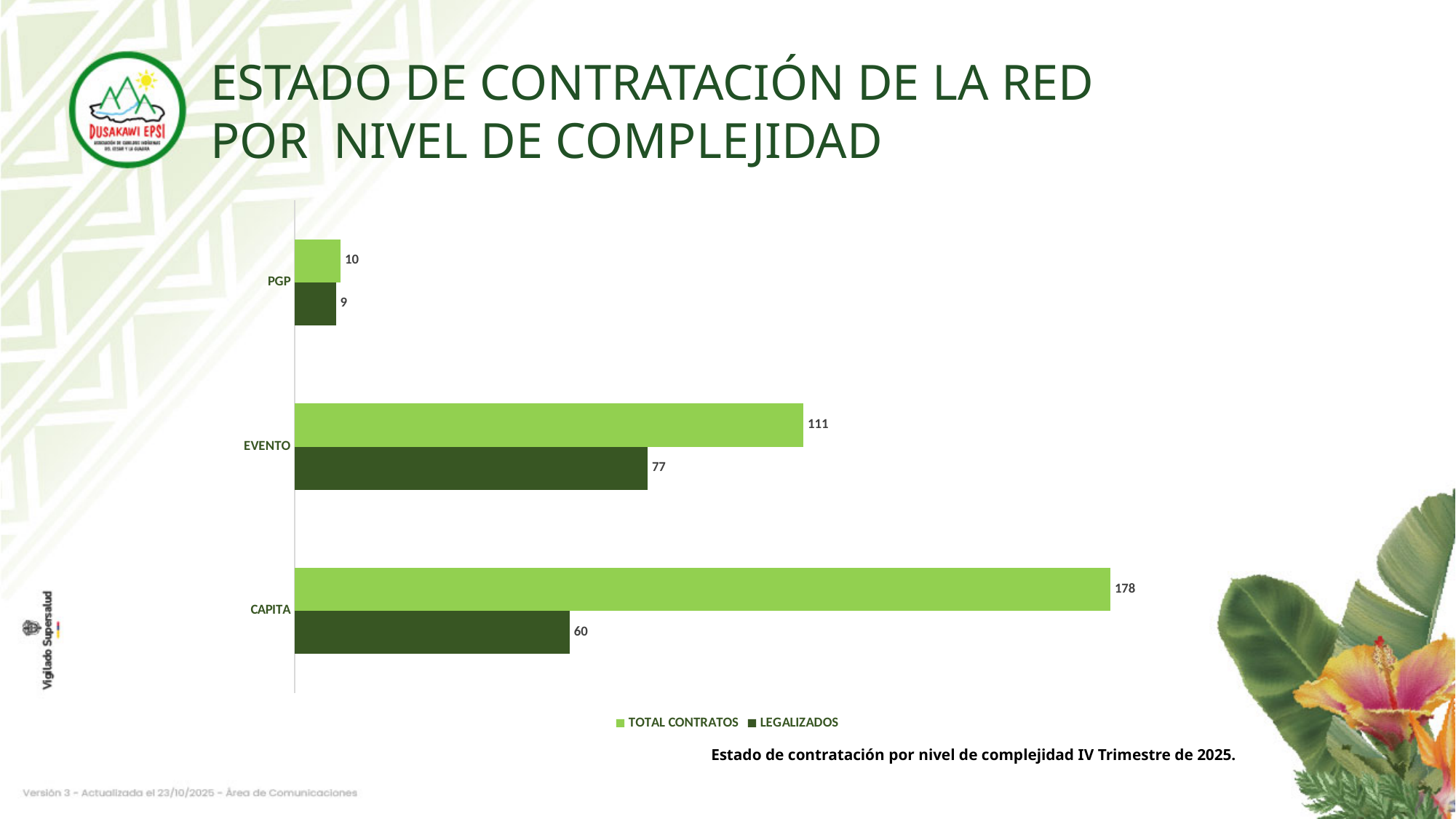
Which category has the highest TOTAL CONTRATOS value? CAPITA Which is larger: LEGALIZADOS for EVENTO or LEGALIZADOS for CAPITA? LEGALIZADOS for EVENTO What is the TOTAL CONTRATOS value for CAPITA? 178 What is the difference between TOTAL CONTRATOS and LEGALIZADOS for CAPITA? 118 What is the LEGALIZADOS value for EVENTO? 77 Which category has the lowest LEGALIZADOS value? PGP What is the difference between TOTAL CONTRATOS for CAPITA and TOTAL CONTRATOS for EVENTO? 67 Which series is shown in dark green in the legend? LEGALIZADOS What kind of chart is shown on the slide? Bar chart What is the LEGALIZADOS value for PGP? 9 How many series does the legend list? 2 How many categories are shown on the chart? 3